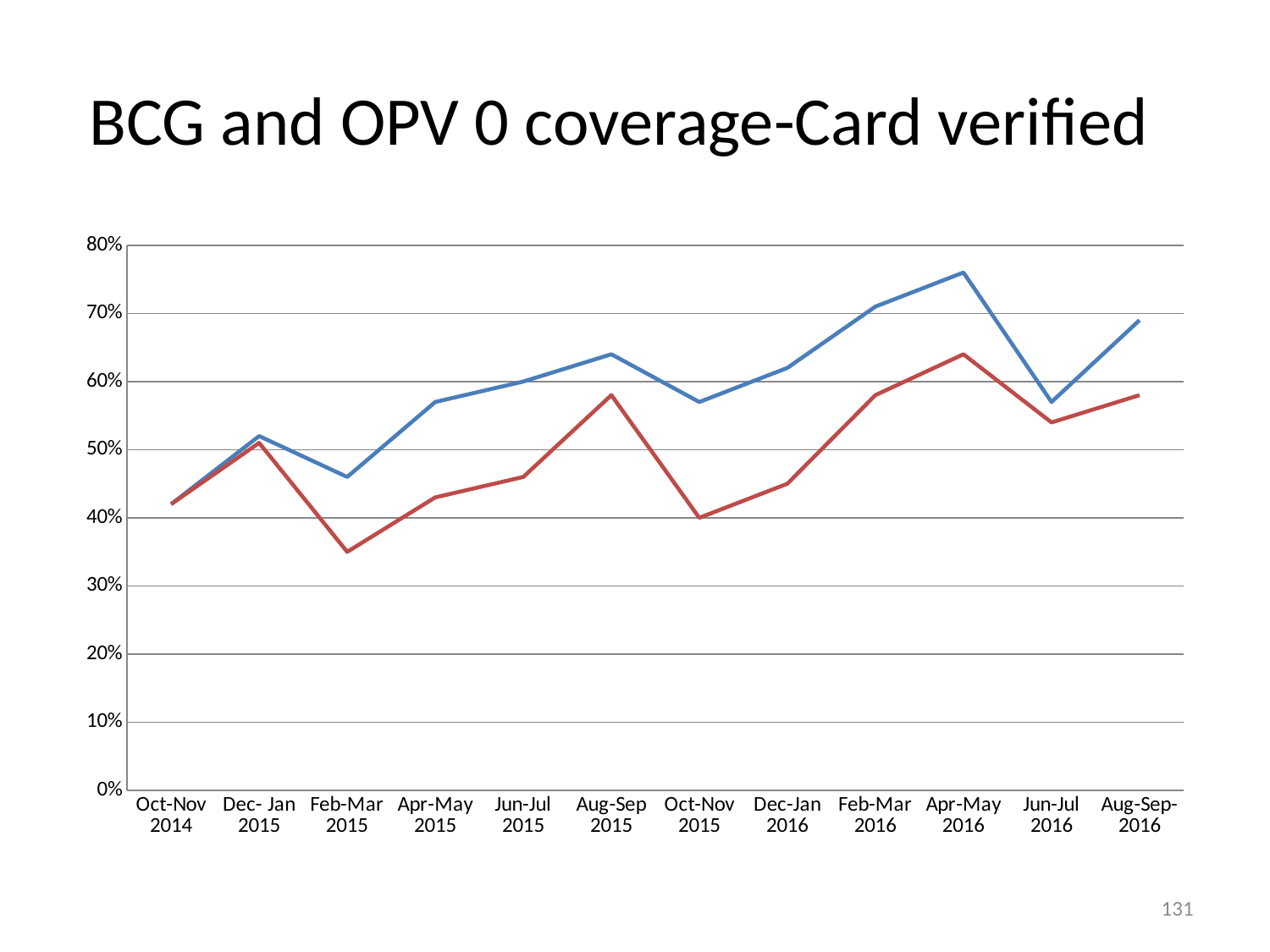
In which period does the red line reach its highest value? Apr-May 2016 How many time periods are shown along the x axis? 12 What kind of chart is shown on the slide? line chart Is the value of the red line for Aug-Sep 2015 greater or less than 50%? greater What is the title of the chart on the slide? BCG and OPV 0 coverage-Card verified In which period does the blue line have its lowest value? Oct-Nov 2014 In which period does the red line reach its lowest value? Feb-Mar 2015 In which period does the blue line reach its highest value? Apr-May 2016 Which line has the higher value in Feb-Mar 2016, the blue line or the red line? blue line How many lines are plotted on the chart? 2 Is the value of the red line for Feb-Mar 2015 greater or less than 40%? less Is the value of the blue line for Apr-May 2016 greater or less than 70%? greater